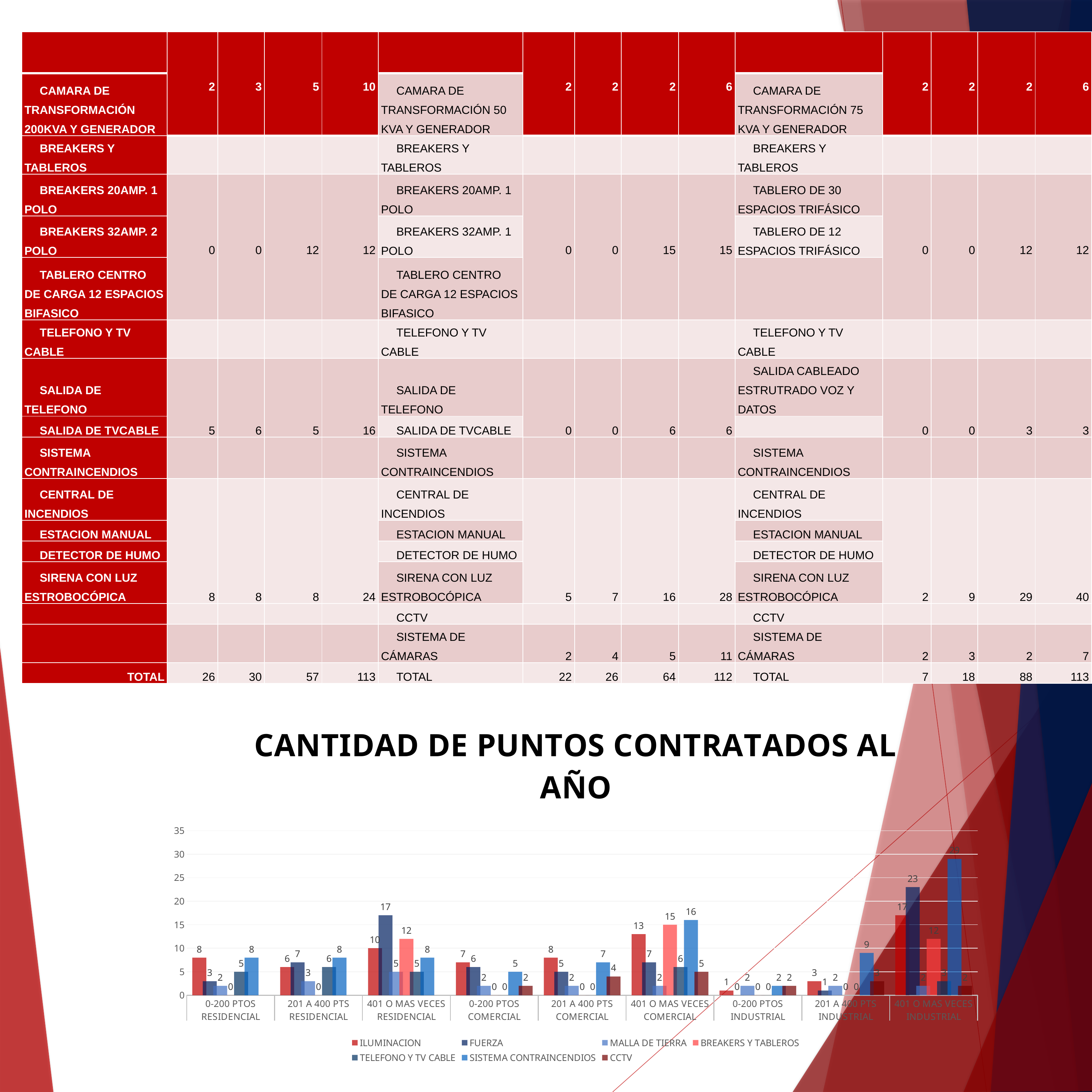
How many categories are shown on the x axis of the "CANTIDAD DE PUNTOS CONTRATADOS AL AÑO" chart? 9 In the "CANTIDAD DE PUNTOS CONTRATADOS AL AÑO" chart, what is the ILUMINACION value for 401 O MAS VECES COMERCIAL? 13 In the "CANTIDAD DE PUNTOS CONTRATADOS AL AÑO" chart, what is the FUERZA value for 401 O MAS VECES RESIDENCIAL? 17 In the "CANTIDAD DE PUNTOS CONTRATADOS AL AÑO" chart, which series has the highest value for 401 O MAS VECES COMERCIAL? SISTEMA CONTRAINCENDIOS In the "CANTIDAD DE PUNTOS CONTRATADOS AL AÑO" chart, what is the difference between the BREAKERS Y TABLEROS values for 401 O MAS VECES COMERCIAL and 401 O MAS VECES RESIDENCIAL? 3 In the "CANTIDAD DE PUNTOS CONTRATADOS AL AÑO" chart, what is the FUERZA value for 401 O MAS VECES INDUSTRIAL? 23 How many series does the legend of the "CANTIDAD DE PUNTOS CONTRATADOS AL AÑO" chart list? 7 What is the title of the bar chart on the slide? CANTIDAD DE PUNTOS CONTRATADOS AL AÑO What kind of chart is shown under the title "CANTIDAD DE PUNTOS CONTRATADOS AL AÑO"? Bar chart In the "CANTIDAD DE PUNTOS CONTRATADOS AL AÑO" chart, is the FUERZA value larger for 401 O MAS VECES INDUSTRIAL or for 401 O MAS VECES RESIDENCIAL? 401 O MAS VECES INDUSTRIAL In the "CANTIDAD DE PUNTOS CONTRATADOS AL AÑO" chart, is the SISTEMA CONTRAINCENDIOS value for 401 O MAS VECES INDUSTRIAL greater or less than 25? greater In the "CANTIDAD DE PUNTOS CONTRATADOS AL AÑO" chart, what is the SISTEMA CONTRAINCENDIOS value for 201 A 400 PTS INDUSTRIAL? 9